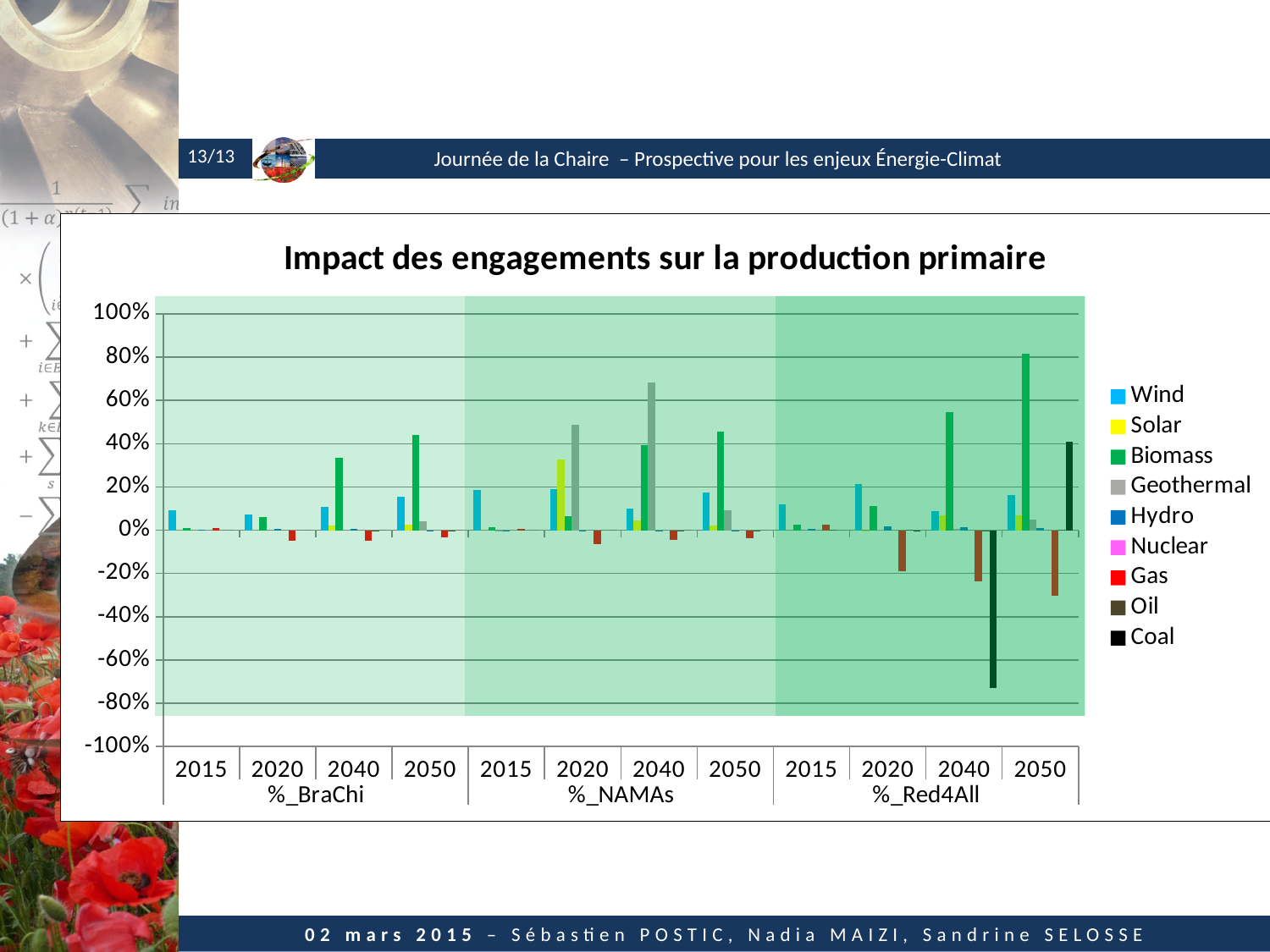
What is the title of the chart? Impact des engagements sur la production primaire How many series does the legend list? 9 Is the value for Geothermal in %_NAMAs 2040 greater or less than 60%? greater How many scenario groups are shown along the x axis? 3 Which series has the tallest bar in the %_Red4All 2050 group? Biomass What kind of chart is shown on the slide? bar chart Is the value for Biomass in %_Red4All 2050 greater or less than 60%? greater Is the value for Biomass in %_Red4All 2040 greater or less than 40%? greater How many years are shown for each scenario on the x axis? 4 Which series has the lowest bar anywhere on the chart? Coal